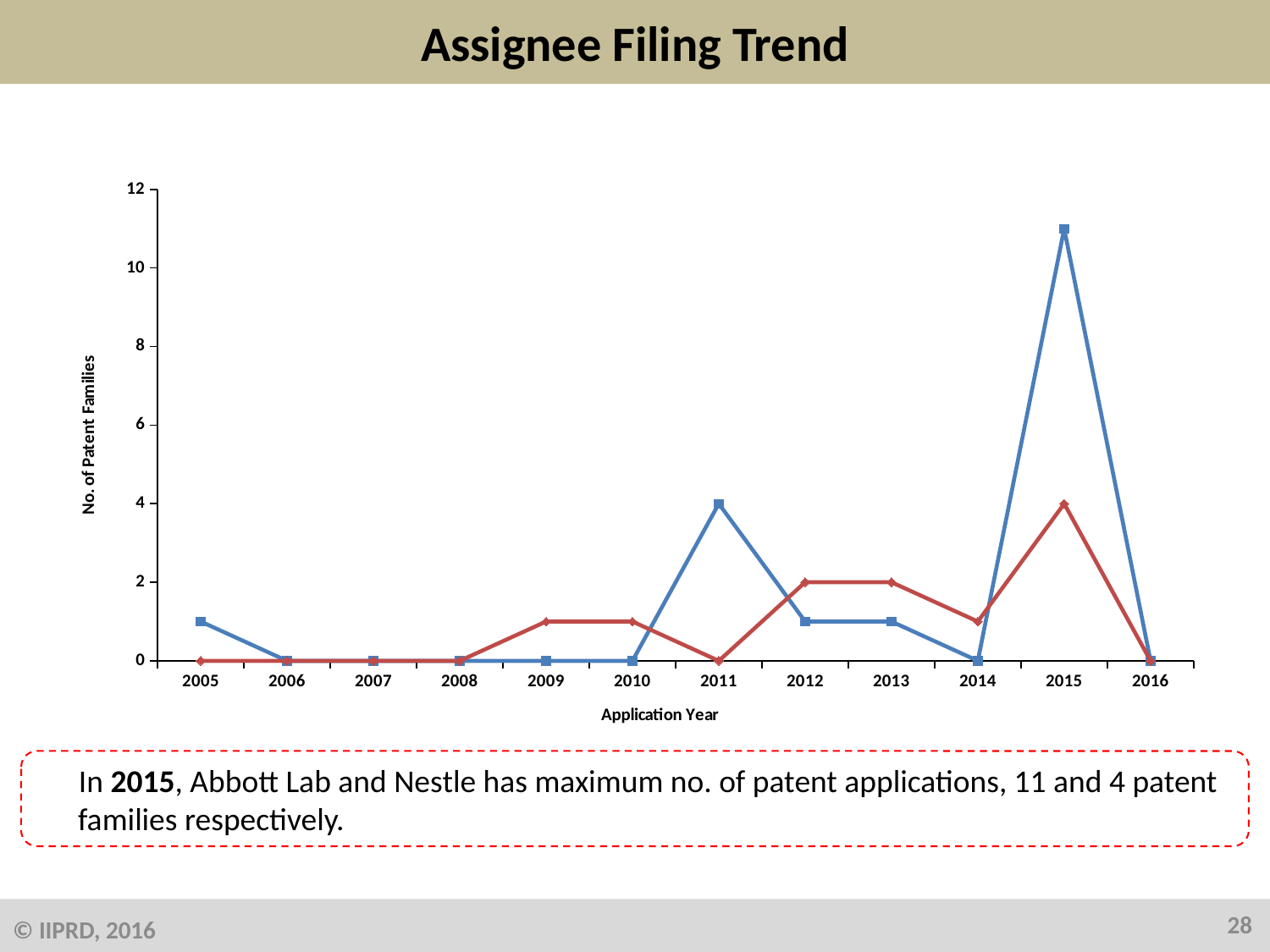
How many patent families does the red line (Nestle) show for 2015? 4 Is the blue line's value for 2015 greater or less than 10? greater What is the title of the y axis? No. of Patent Families What value does the blue line reach in 2011? 4 How many patent families does the blue line (Abbott Lab) show for 2015? 11 In which year does the blue line reach its highest value? 2015 What is the difference between the blue line and the red line values in 2015? 7 What value does the red line show in 2012? 2 How many lines (series) are plotted on the chart? 2 What type of chart is shown on the slide? Line chart In 2011, which line has the larger value, the blue line or the red line? Blue line How many application years are plotted along the x axis? 12